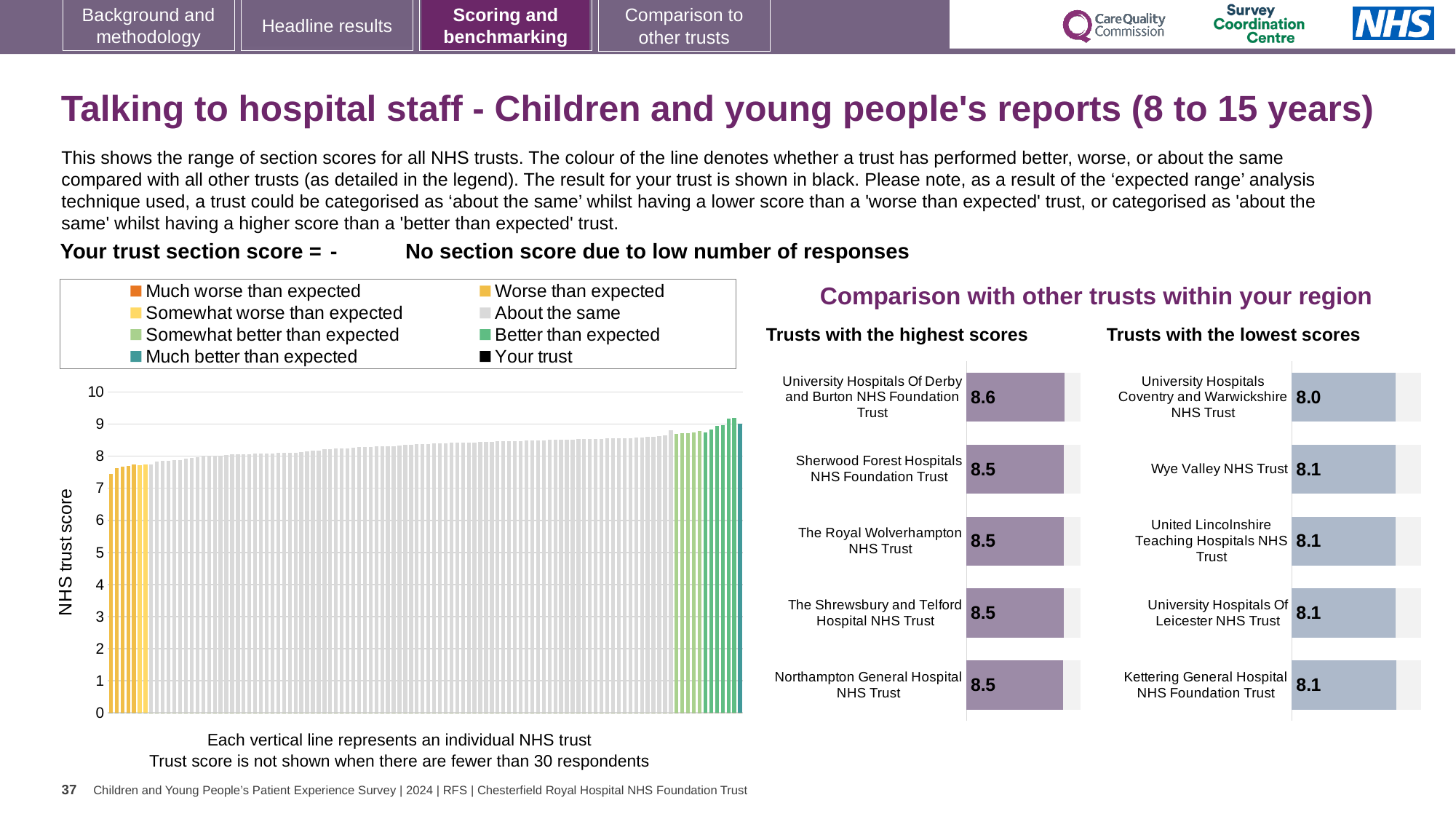
In the 'Trusts with the lowest scores' chart, what is the score for University Hospitals Coventry and Warwickshire NHS Trust? 8.0 What is the difference between the score of University Hospitals Of Derby and Burton NHS Foundation Trust in the highest scores chart and the score of University Hospitals Coventry and Warwickshire NHS Trust in the lowest scores chart? 0.6 What kind of chart is the large chart on the left showing NHS trust scores? bar chart In the large chart on the left, do the trust scores rise or fall from left to right along the x axis? rise In the large chart on the left, is the value of the leftmost (lowest) bar greater or less than 8? less In the 'Trusts with the highest scores' chart, is the score for Sherwood Forest Hospitals NHS Foundation Trust larger or smaller than the score for University Hospitals Of Derby and Burton NHS Foundation Trust? smaller In the 'Trusts with the lowest scores' chart, what is the score for Wye Valley NHS Trust? 8.1 In the 'Trusts with the highest scores' chart, how many trusts are listed? 5 In the 'Trusts with the highest scores' chart, which trust has the highest score? University Hospitals Of Derby and Burton NHS Foundation Trust How many entries does the legend above the large chart on the left list? 8 In the 'Trusts with the highest scores' chart, what is the score for University Hospitals Of Derby and Burton NHS Foundation Trust? 8.6 In the 'Trusts with the lowest scores' chart, which trust has the lowest score? University Hospitals Coventry and Warwickshire NHS Trust